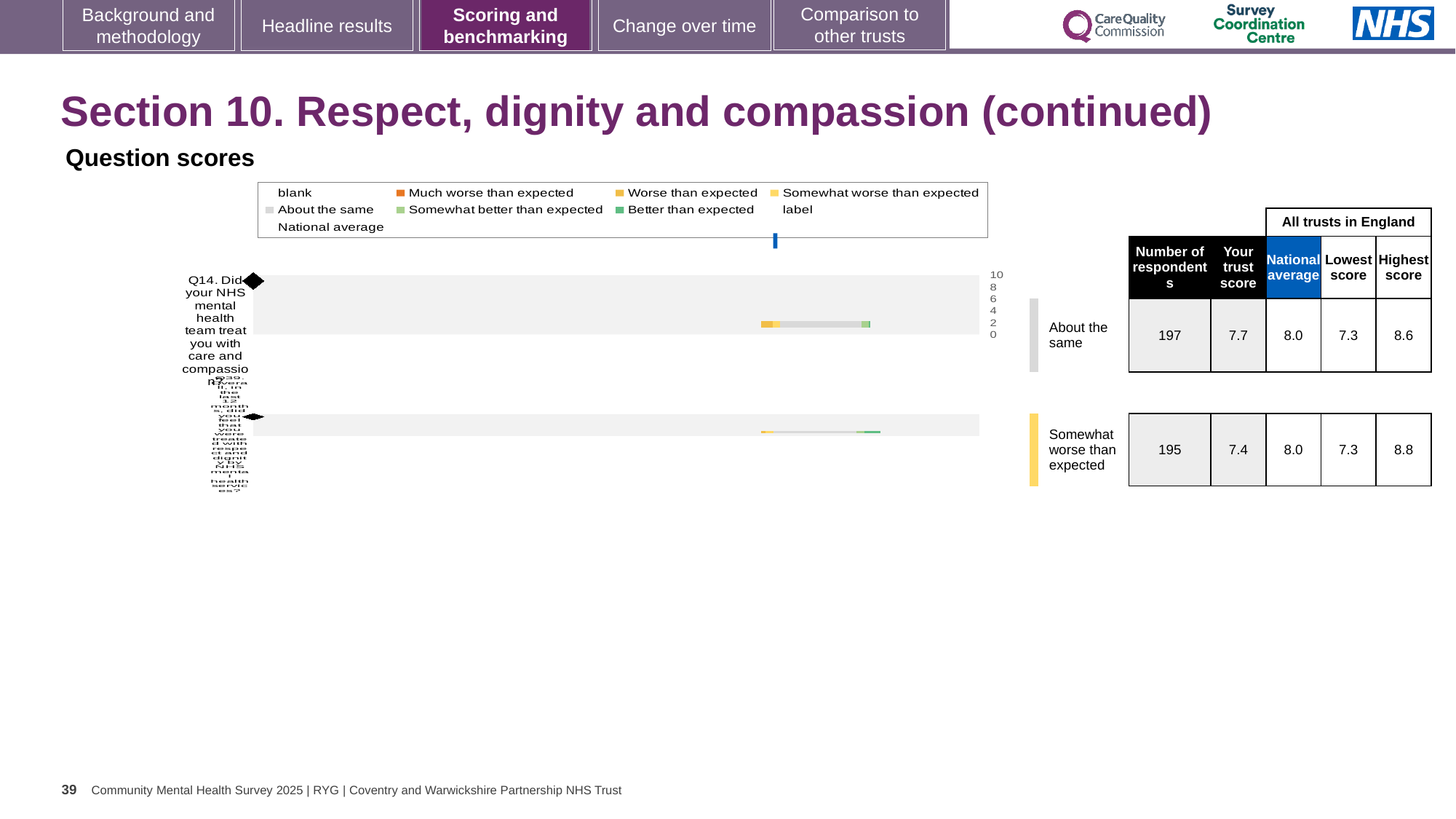
How many respondents answered Q14 according to the table? 197 Which question has the higher trust score, Q14 or the second question (Q39)? Q14 What kind of chart is used to show the question scores on this slide? bar chart Which benchmark category is shown next to the bar for Q14? About the same What is the national average score for Q14? 8.0 How many respondents answered the second question (Q39)? 195 How many questions are plotted in the question scores chart? 2 What is the highest score among all trusts in England for the second question (Q39)? 8.8 By how much is the national average for Q14 higher than the trust score for Q14? 0.3 What is the highest score among all trusts in England for Q14? 8.6 What is the trust score for the second question (Q39) in the table? 7.4 What is the trust score for Q14 (care and compassion) in the table beside the chart? 7.7